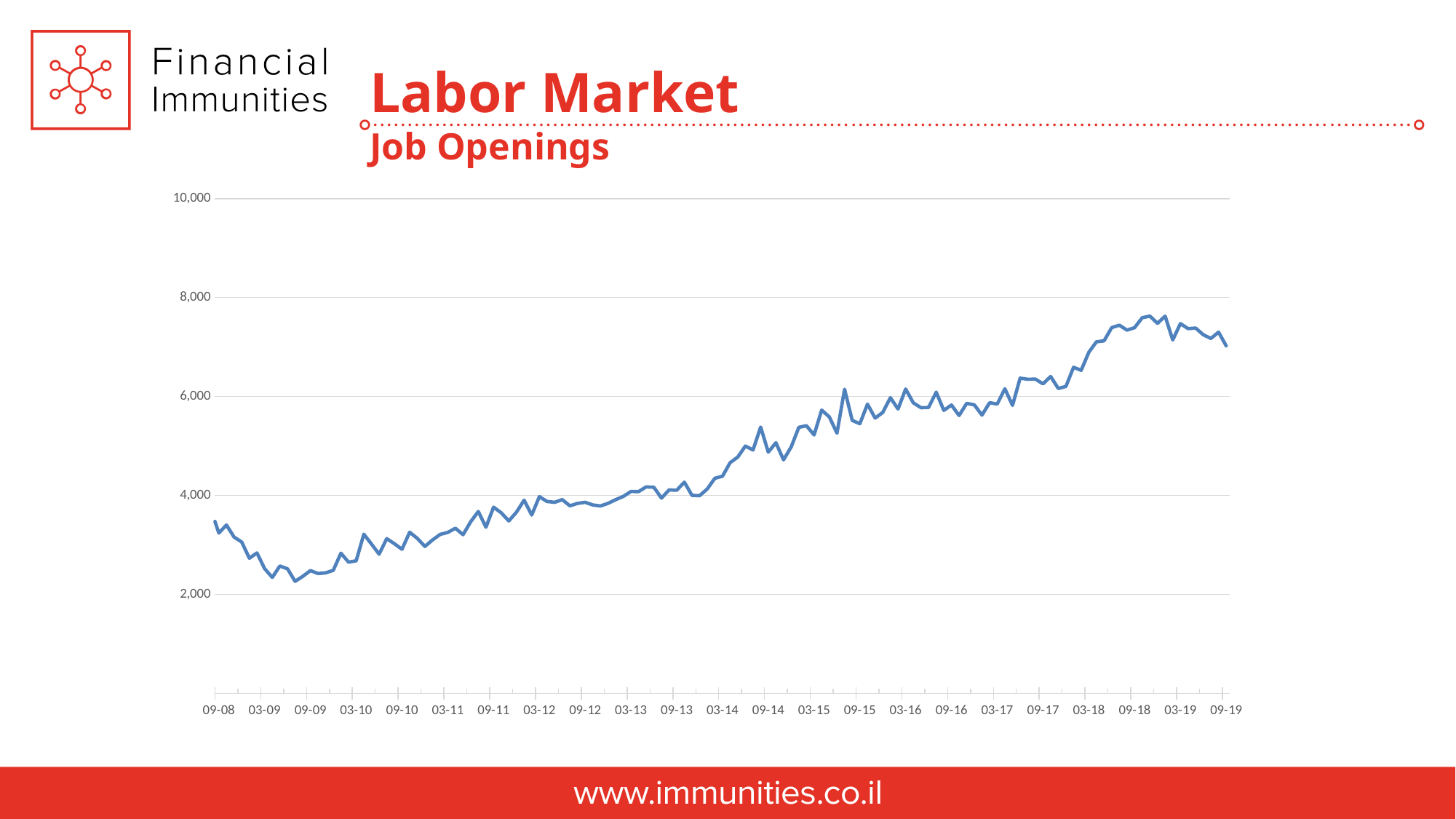
Is the highest value on the chart greater or less than 8,000? less Which is larger, the value at 09-19 or the value at 09-08? 09-19 Is the value at 09-19 greater or less than 6,000? greater What kind of chart is shown on the slide? Line chart Is the value at 09-09 greater or less than 4,000? less What is the title of the chart? Job Openings Overall, do the values rise or fall from 09-08 to 09-19? Rise What is the highest value shown on the y axis? 10,000 How many date labels are shown on the x axis? 23